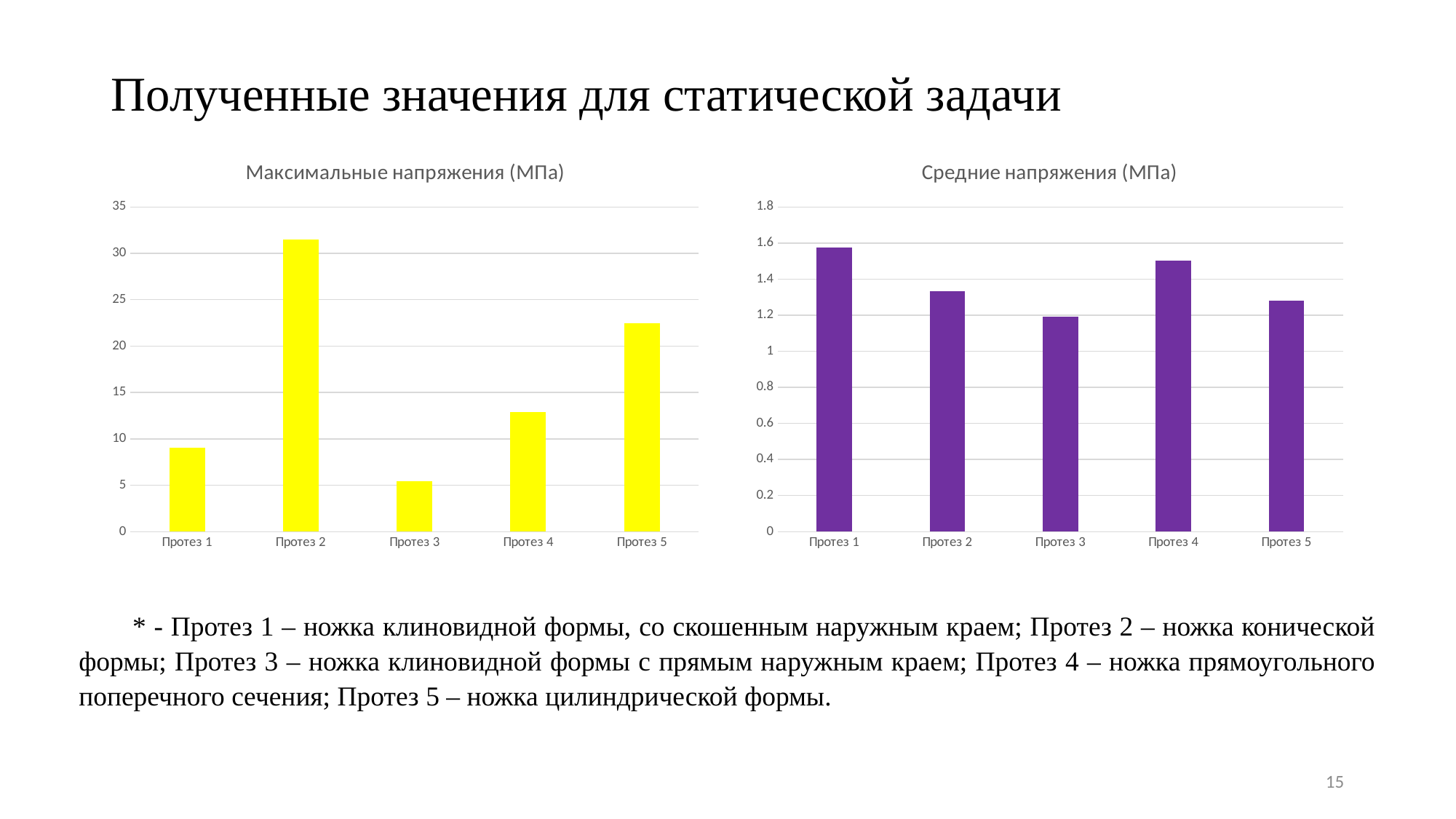
In the chart titled "Максимальные напряжения (МПа)", is the value for Протез 2 greater or less than 30? greater In the chart titled "Средние напряжения (МПа)", which is larger, the value for Протез 2 or the value for Протез 5? Протез 2 In the chart titled "Средние напряжения (МПа)", which category has the lowest value? Протез 3 In the chart titled "Средние напряжения (МПа)", which category has the highest value? Протез 1 How many categories are shown in the chart titled "Максимальные напряжения (МПа)"? 5 In the chart titled "Максимальные напряжения (МПа)", which is larger, the value for Протез 4 or the value for Протез 5? Протез 5 In the chart titled "Максимальные напряжения (МПа)", is the value for Протез 1 greater or less than 10? less In the chart titled "Максимальные напряжения (МПа)", which category has the lowest value? Протез 3 In the chart titled "Средние напряжения (МПа)", is the value for Протез 4 greater or less than 1.4? greater What kind of chart is the chart on the right of the slide? Bar chart In the chart titled "Максимальные напряжения (МПа)", which category has the highest value? Протез 2